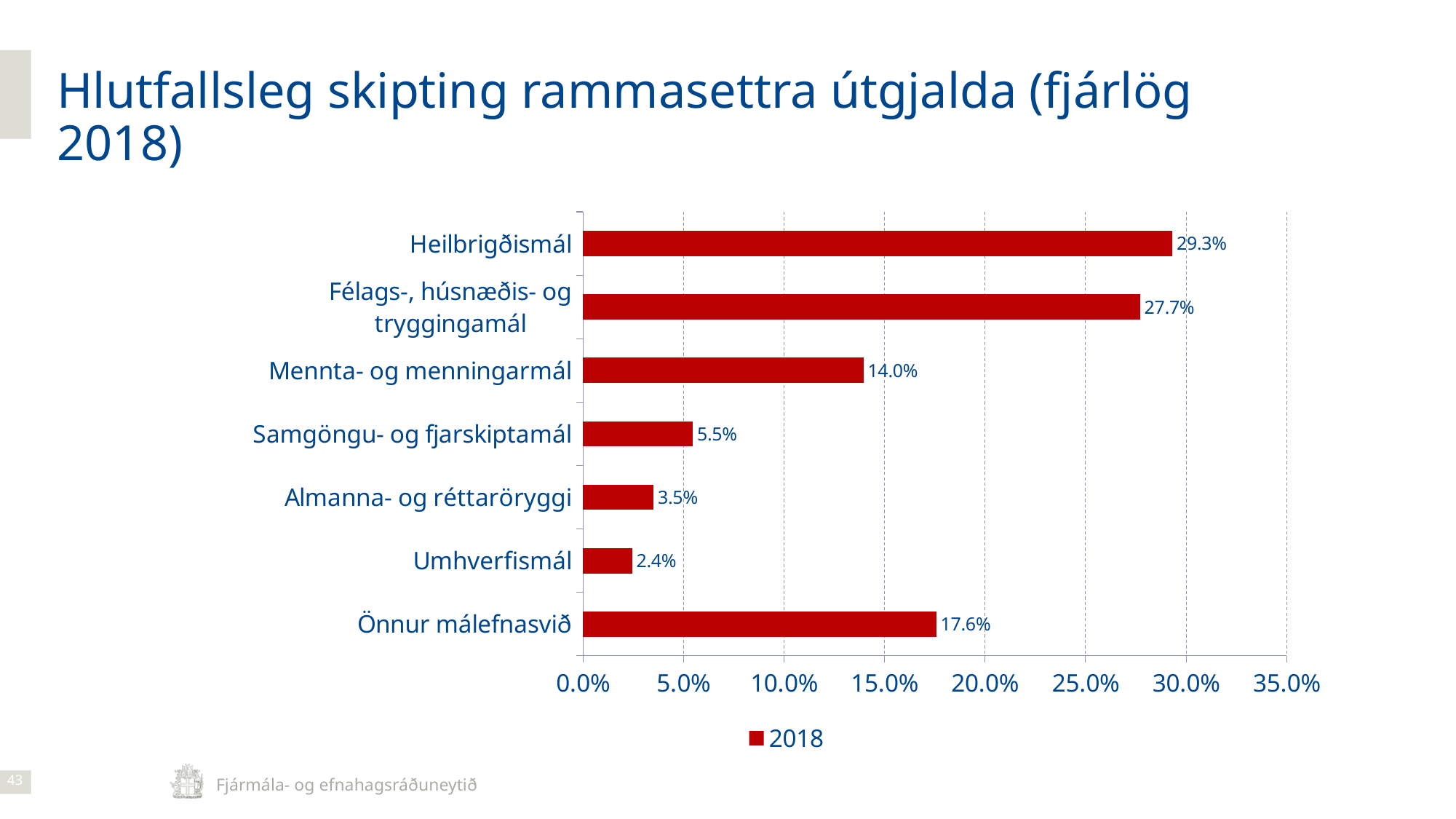
How many categories are shown in the chart? 7 What is the value for Mennta- og menningarmál? 14.0% What is the value for Umhverfismál? 2.4% What series does the legend list? 2018 What kind of chart is shown on the slide? bar chart What is the difference between the values for Heilbrigðismál and Félags-, húsnæðis- og tryggingamál? 1.6% Is the value for Önnur málefnasvið greater or less than 15.0%? greater What is the value for Önnur málefnasvið? 17.6% Which category has the highest value? Heilbrigðismál Which is larger, the value for Samgöngu- og fjarskiptamál or the value for Almanna- og réttaröryggi? Samgöngu- og fjarskiptamál Which category has the lowest value? Umhverfismál What is the value for Heilbrigðismál? 29.3%